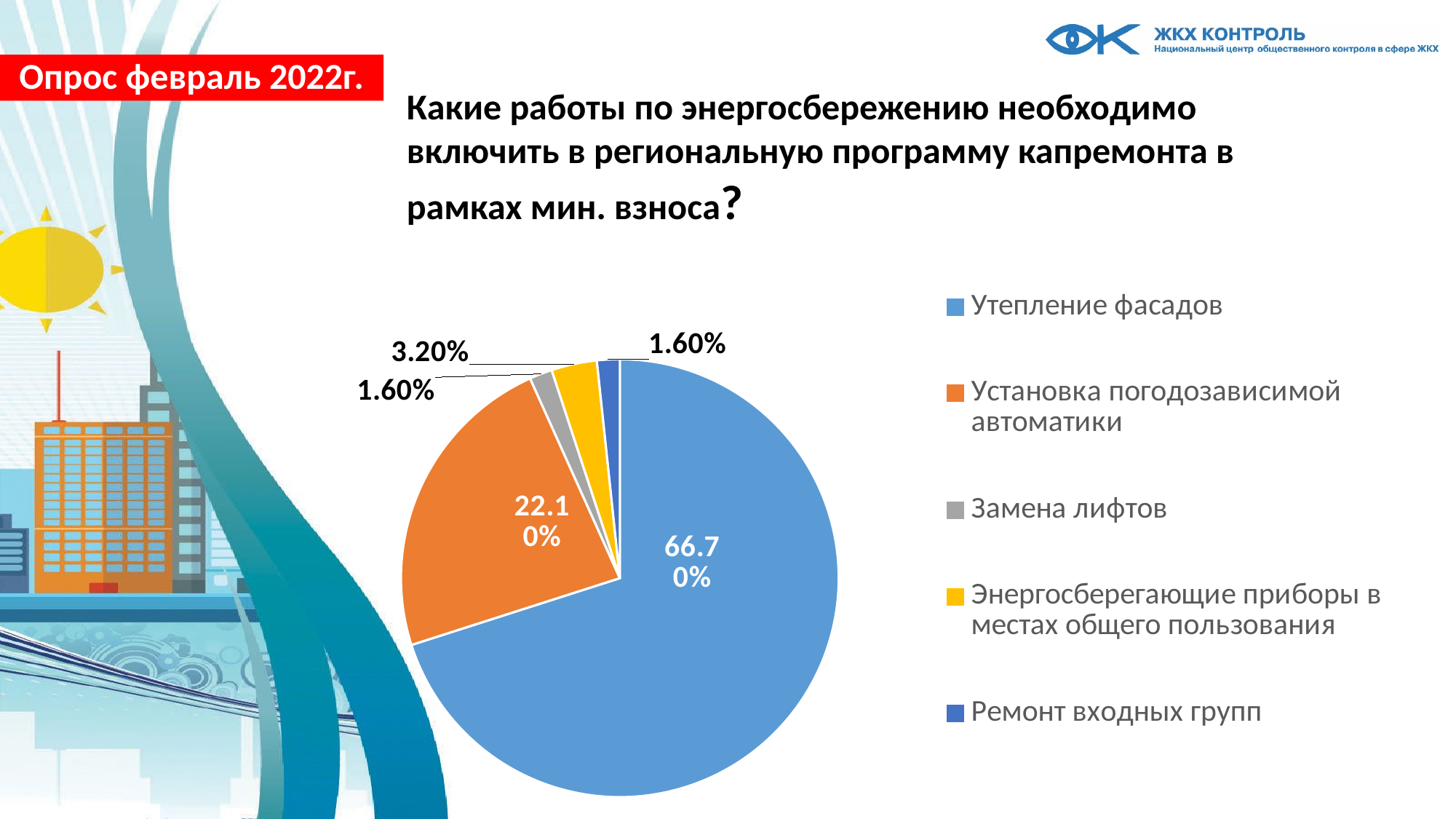
Which is larger: the share of Энергосберегающие приборы в местах общего пользования or the share of Замена лифтов? Энергосберегающие приборы в местах общего пользования What share of the pie does Замена лифтов have? 1.60% What share of the pie does Ремонт входных групп have? 1.60% How many slices does the pie chart have? 5 What colour is the slice for Установка погодозависимой автоматики? orange What share of the pie does Установка погодозависимой автоматики have? 22.10% What kind of chart is shown on the slide? pie chart What is the difference between the shares of Утепление фасадов and Установка погодозависимой автоматики? 44.60% Which category has the largest slice of the pie? Утепление фасадов What share of the pie does Энергосберегающие приборы в местах общего пользования have? 3.20% What share of the pie does Утепление фасадов have? 66.70% How many entries does the legend list? 5